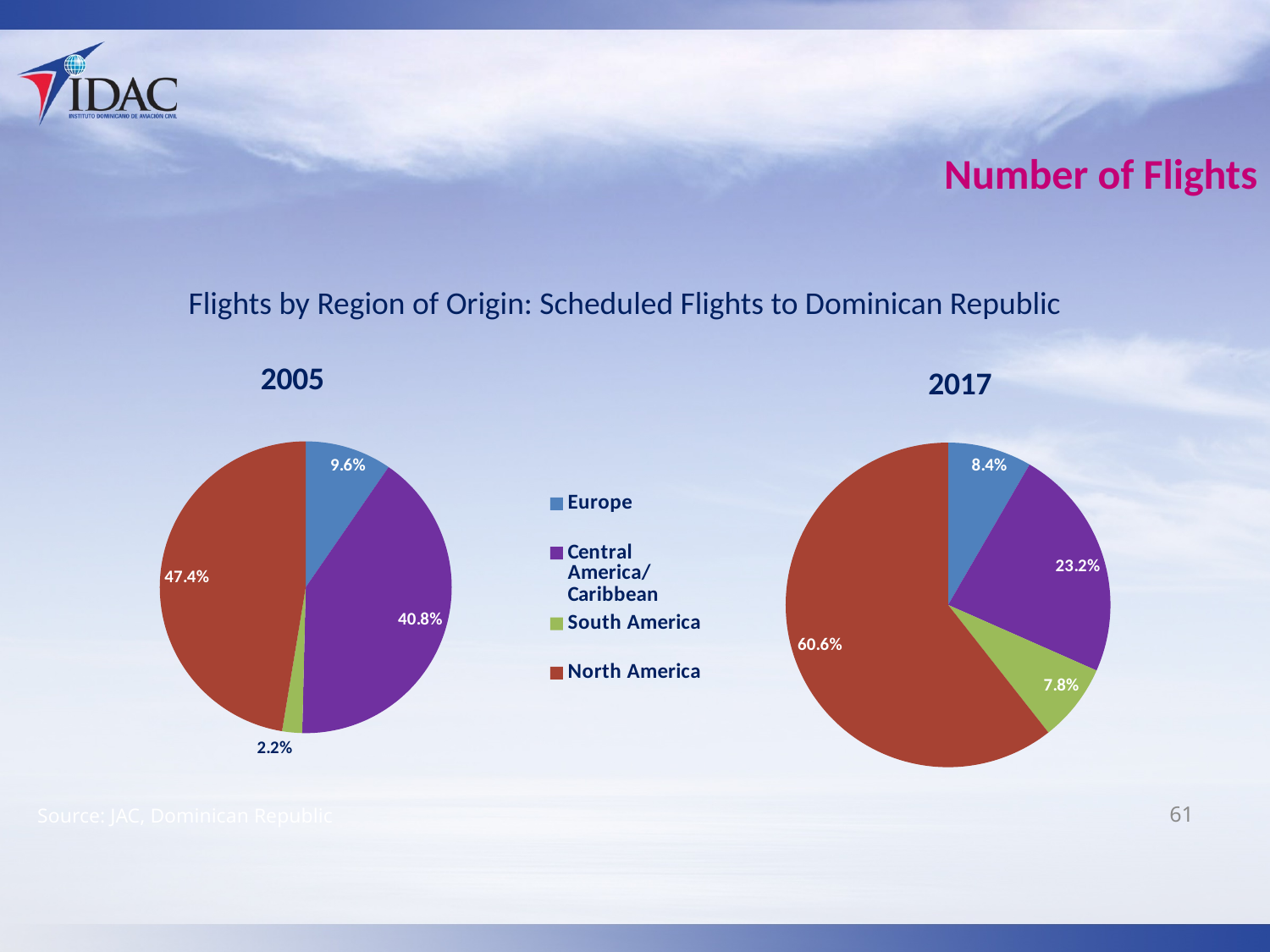
In the 2005 pie chart, what share of flights came from South America? 2.2% What colour represents North America in the pie charts? Red In the 2005 pie chart, which region has the smallest share? South America What kind of charts are shown on the slide? Pie charts In the 2017 pie chart, what share of flights came from Central America/Caribbean? 23.2% In the 2005 pie chart, what share of flights came from North America? 47.4% How many regions does the legend list? 4 In the 2017 pie chart, which region has the largest share? North America In the 2017 pie chart, which region has the smallest share? South America In the 2005 pie chart, which is larger: the Europe share or the Central America/Caribbean share? Central America/Caribbean In the 2017 pie chart, what share of flights came from Europe? 8.4% What is the difference between the North America share in 2017 and in 2005? 13.2%